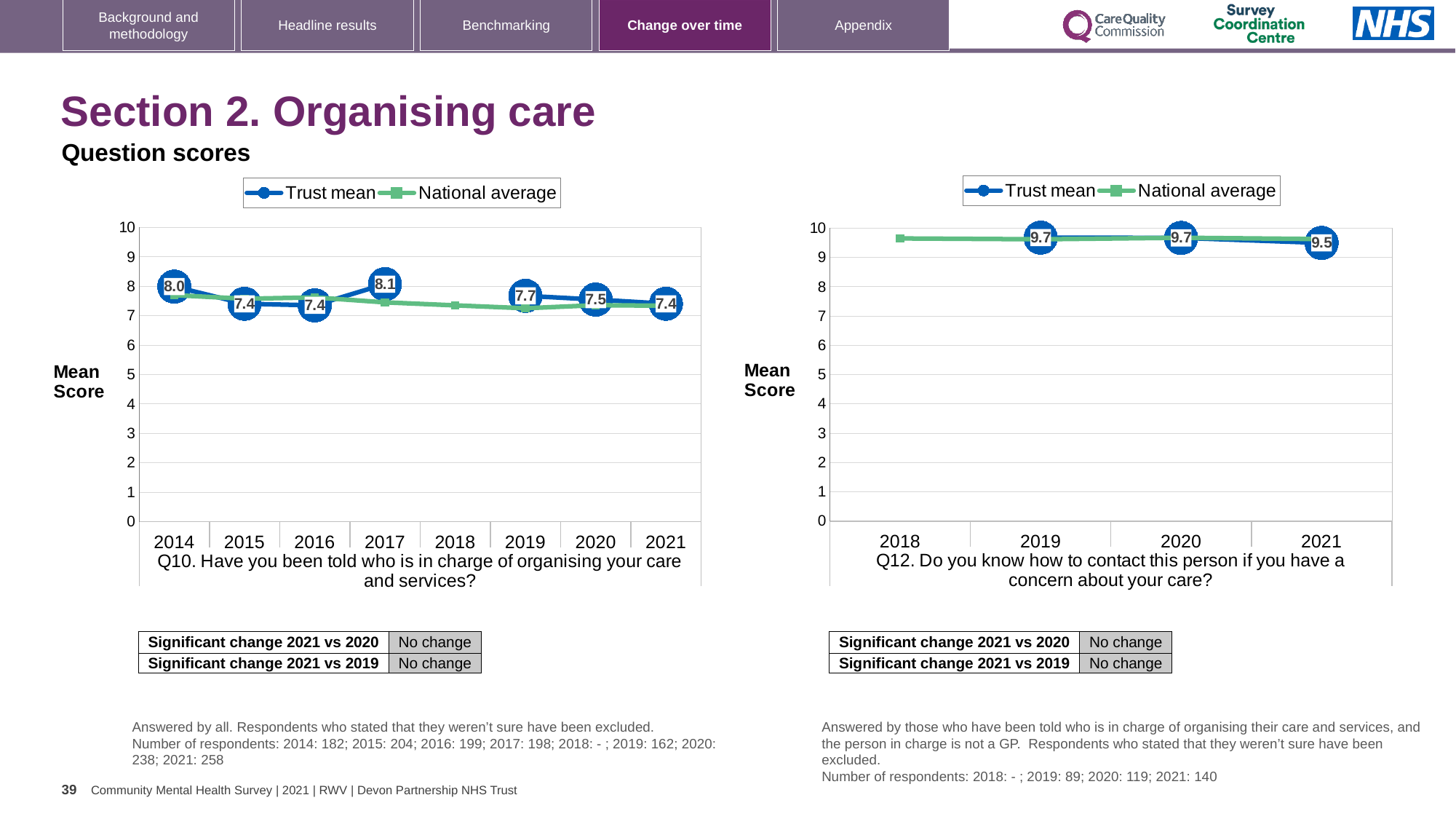
How many years are shown on the x axis of the Q12 chart on the right? 4 In the Q12 chart on the right, which year has the lowest labelled Trust mean? 2021 What kind of chart is the Q10 chart on the left? Line chart In the Q12 chart on the right, is the National average for 2018 greater or less than 9? greater How many series does the legend of the Q10 chart on the left list? 2 In the Q10 chart on the left, what is the Trust mean for 2017? 8.1 In the Q12 chart on the right, what is the difference between the Trust mean in 2020 and in 2021? 0.2 In the Q12 chart on the right, what is the Trust mean for 2021? 9.5 In the Q10 chart on the left, which year has the highest Trust mean? 2017 In the Q10 chart on the left, what is the Trust mean for 2021? 7.4 In the Q10 chart on the left, what is the difference between the Trust mean in 2017 and in 2021? 0.7 In the Q10 chart on the left, is the Trust mean higher in 2014 or in 2020? 2014